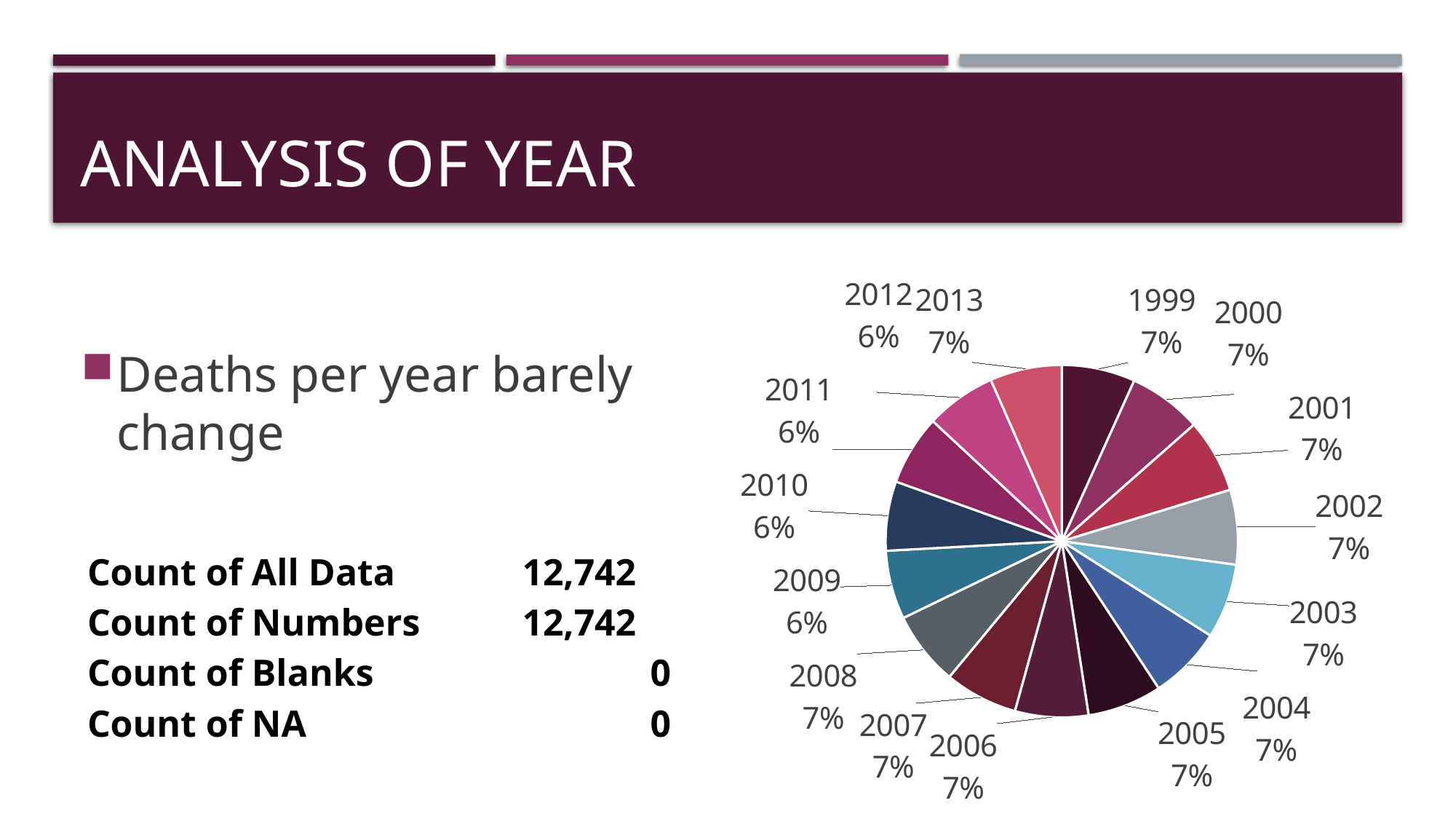
How many slices (years) does the pie chart have? 15 Which years in the pie chart are labelled 6%? 2009, 2010, 2011, 2012 What share of the pie does 1999 account for? 7% What percentage is shown for 2013 in the pie chart? 7% How many years in the pie chart are labelled 6%? 4 What is the earliest year shown in the pie chart? 1999 What percentage is shown for 2009 in the pie chart? 6% Which has the larger share in the pie chart, 2008 or 2010? 2008 What percentage is shown for 2005 in the pie chart? 7% What is the difference between the share for 2001 and the share for 2011? 1% What share of the pie does 2012 account for? 6% What kind of chart is shown on the slide? pie chart